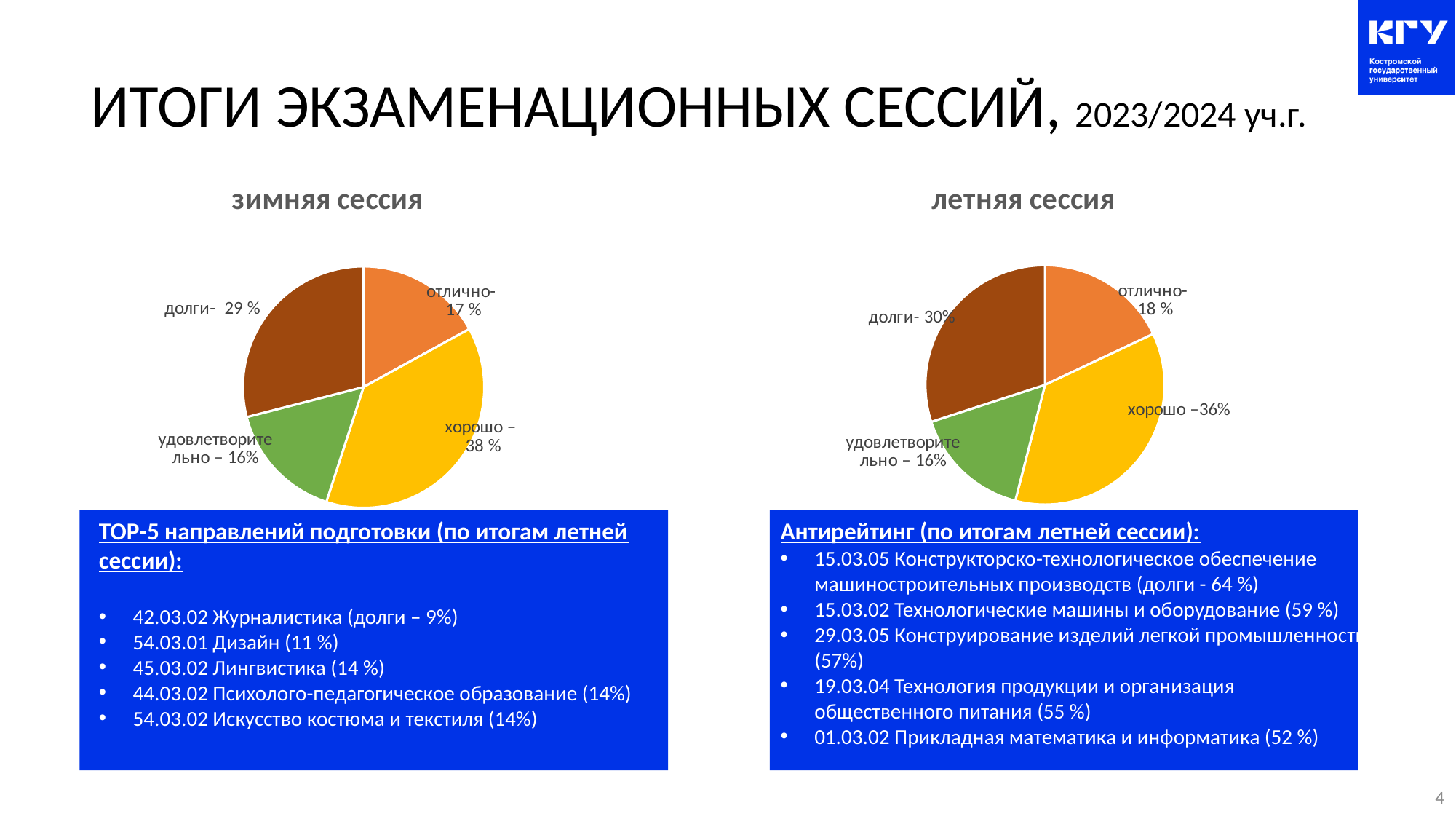
In the "зимняя сессия" chart, what is the share for "долги"? 29 % In the "летняя сессия" chart, which category has the largest share? хорошо In the "летняя сессия" chart, what is the difference between the shares for "долги" and "отлично"? 12 percentage points In the "летняя сессия" chart, what is the share for "хорошо"? 36% In the "зимняя сессия" chart, which category has the smallest share? удовлетворительно In the "зимняя сессия" chart, what is the share for "отлично"? 17 % In the "летняя сессия" chart, what is the share for "долги"? 30% In the "зимняя сессия" chart, what is the difference between the shares for "хорошо" and "удовлетворительно"? 22 percentage points What type of chart is used for the "зимняя сессия" chart? pie chart In the "зимняя сессия" chart, which is larger: the share for "долги" or the share for "отлично"? долги How many slices does the "летняя сессия" pie chart have? 4 In the "зимняя сессия" chart, which category has the largest share? хорошо